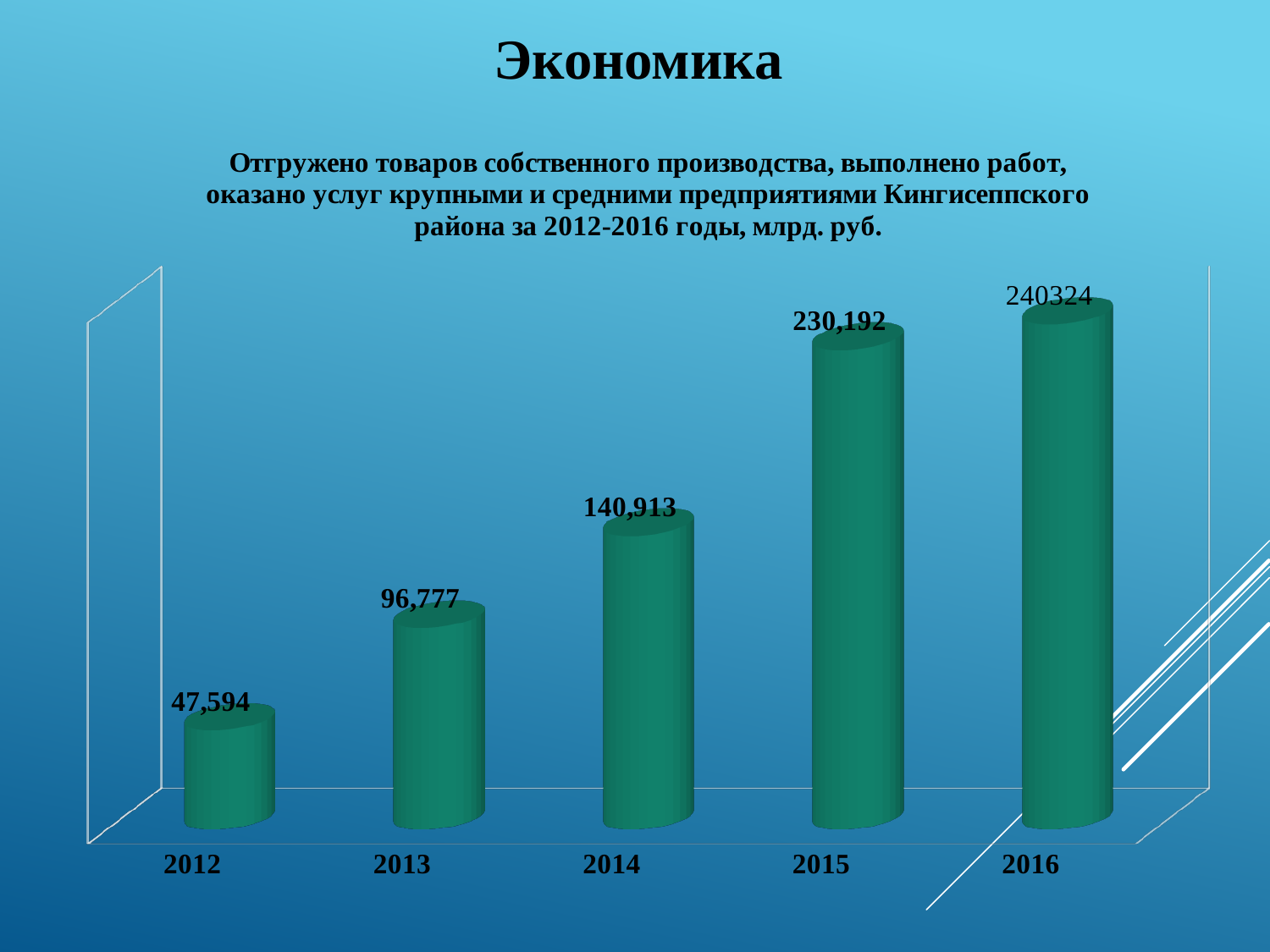
What kind of chart is shown on the slide? Bar chart What is the value for 2014? 140,913 Which year has the lowest value? 2012 What is the value for 2015? 230,192 Which year has the highest value? 2016 Which is larger, the value for 2013 or the value for 2014? 2014 Do the values rise or fall from 2012 to 2016? Rise How many years are shown on the x axis? 5 What unit of measurement is stated in the chart title? млрд. руб. What is the value for 2013? 96,777 What is the value for 2016? 240324 What is the value for 2012? 47,594